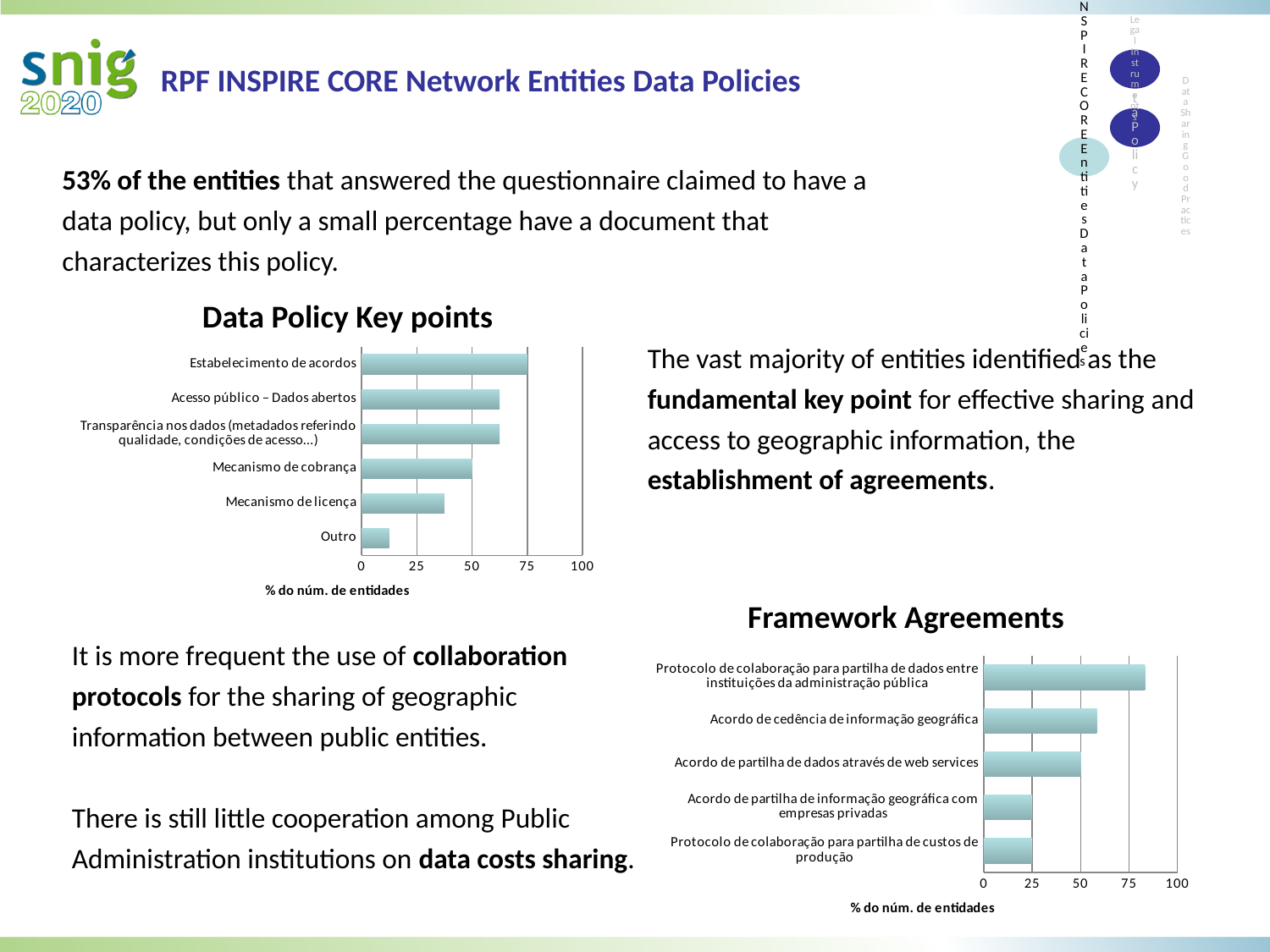
How many categories are shown in the "Data Policy Key points" chart? 6 What type of chart is the "Data Policy Key points" chart? bar chart In the "Framework Agreements" chart, which is larger: Acordo de cedência de informação geográfica or Acordo de partilha de informação geográfica com empresas privadas? Acordo de cedência de informação geográfica In the "Data Policy Key points" chart, which category has the lowest value? Outro How many categories are shown in the "Framework Agreements" chart? 5 In the "Data Policy Key points" chart, which is larger: Mecanismo de cobrança or Mecanismo de licença? Mecanismo de cobrança In the "Data Policy Key points" chart, is the value for Acesso público – Dados abertos greater or less than 50? greater In the "Data Policy Key points" chart, is the value for Mecanismo de licença greater or less than 50? less What is the x-axis label of the "Data Policy Key points" chart? % do núm. de entidades In the "Data Policy Key points" chart, which category has the highest value? Estabelecimento de acordos In the "Framework Agreements" chart, which category has the highest value? Protocolo de colaboração para partilha de dados entre instituições da administração pública In the "Framework Agreements" chart, is the value for Protocolo de colaboração para partilha de dados entre instituições da administração pública greater or less than 75? greater